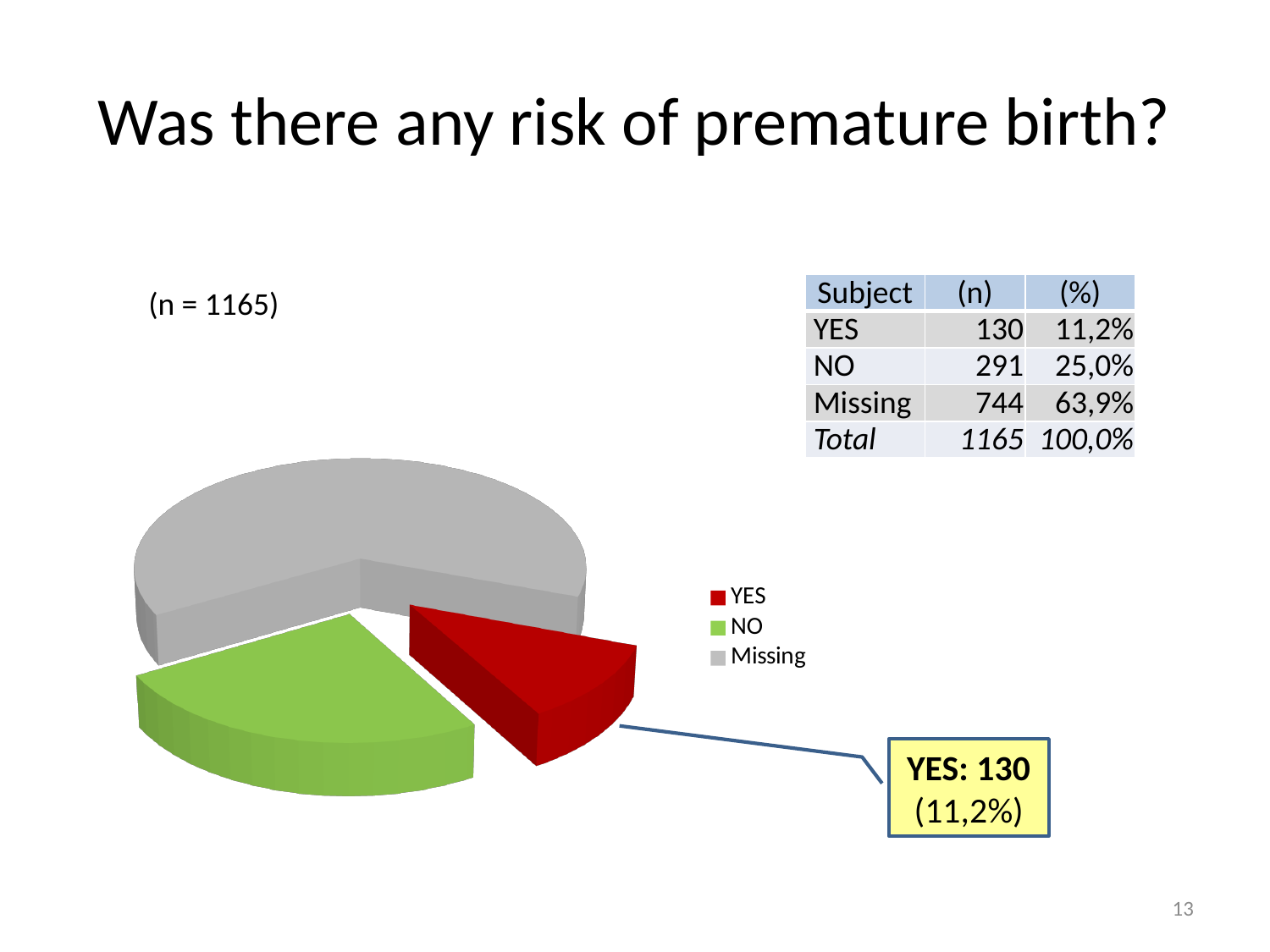
What is the difference between the Missing count and the NO count? 453 How many slices does the pie chart have? 3 How many entries does the legend list? 3 What is the value for YES shown in the callout on the pie chart? 130 Which category has the smallest slice of the pie? YES What percentage share does the YES slice have? 11,2% Which category has the largest slice of the pie? Missing Which colour represents the NO slice in the pie chart? green What percentage share does the Missing slice have? 63,9% What is the value for NO in the table? 291 What is the value for Missing in the table? 744 What kind of chart is shown on the slide? pie chart